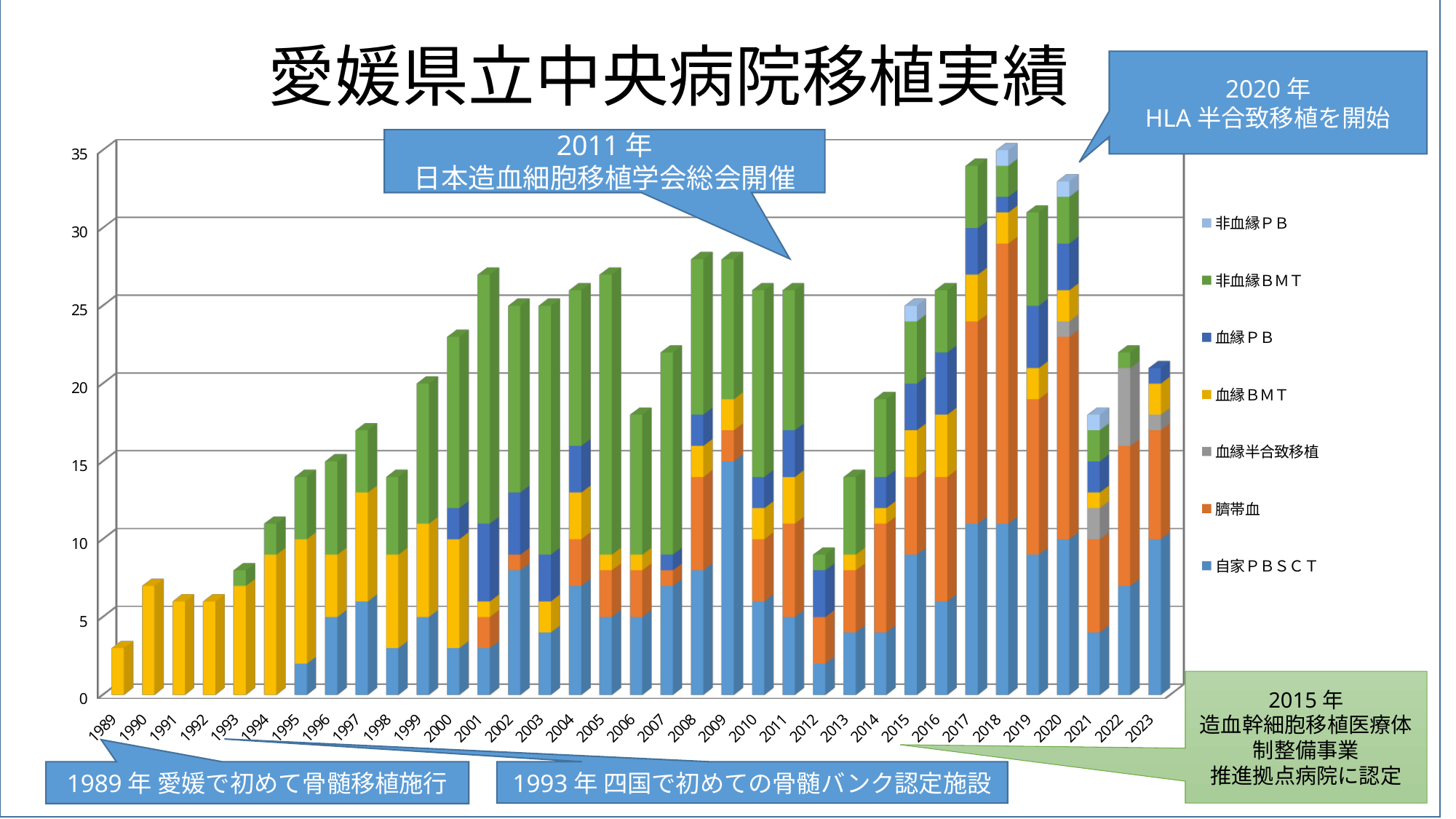
Is the total for 1989 greater or less than 5? less Is the total for 2018 greater or less than 30? greater Which year has the tallest stacked bar? 2018 How many years are shown along the x axis? 35 Which legend entry corresponds to the bottom (light blue) segment of the stacked bars? 自家ＰＢＳＣＴ Which year has a larger total, 2009 or 2012? 2009 Is the total for 2012 greater or less than 10? less Do the totals generally rise or fall from 1989 to 2001? rise What kind of chart is shown on the slide? Stacked bar chart What is the title of the chart? 愛媛県立中央病院移植実績 How many series does the legend list? 7 Which year has the shortest stacked bar? 1989